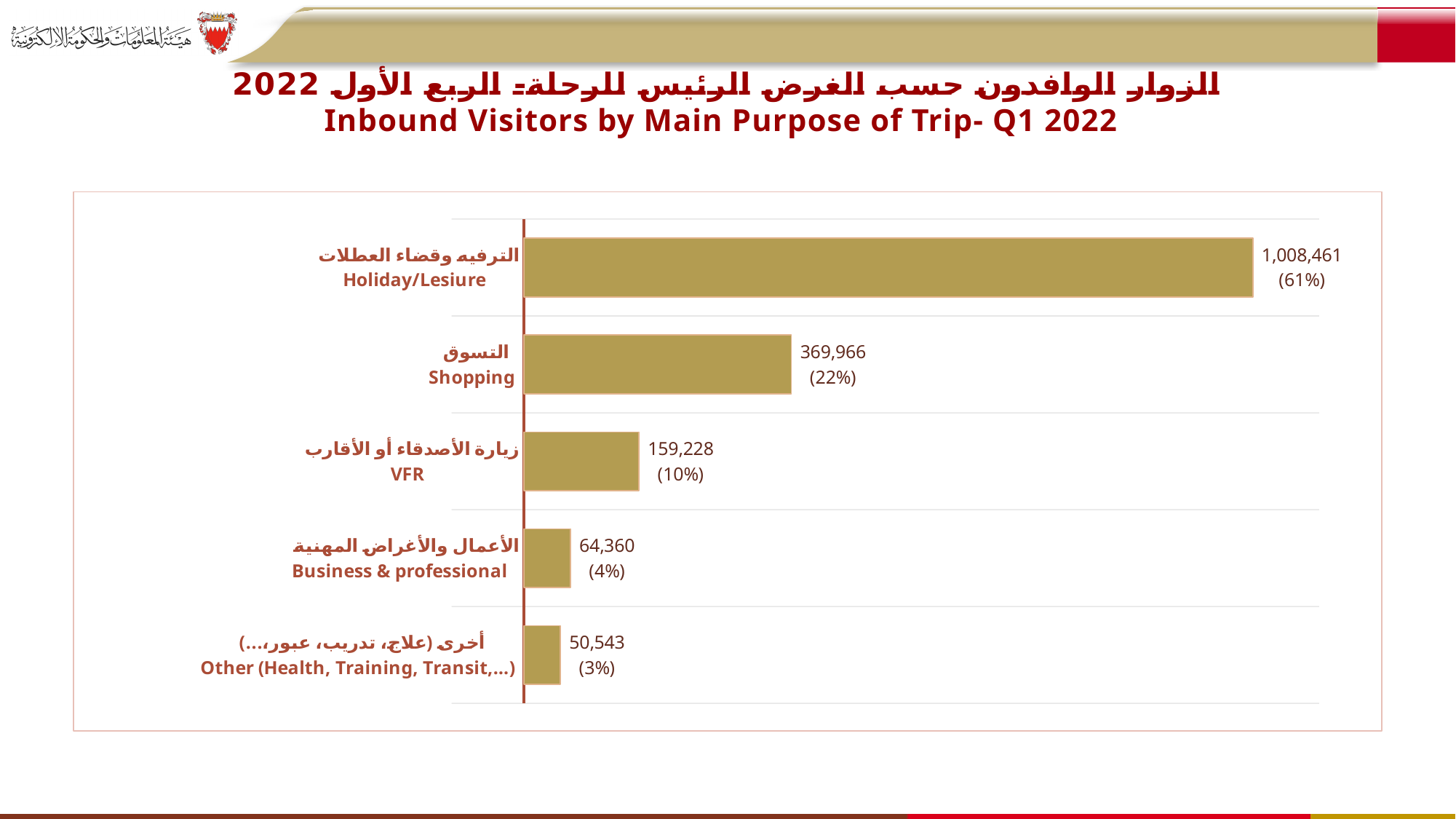
What is the number of inbound visitors for VFR? 159,228 What is the English title of the chart on this slide? Inbound Visitors by Main Purpose of Trip- Q1 2022 Which main purpose of trip has the lowest number of inbound visitors? Other (Health, Training, Transit,...) What is the difference in inbound visitors between Shopping and VFR? 210,738 What is the number of inbound visitors for Holiday/Lesiure? 1,008,461 What is the number of inbound visitors for Shopping? 369,966 What kind of chart is used on this slide? Bar chart What percentage share is shown for Other (Health, Training, Transit,...)? 3% What is the number of inbound visitors for Business & professional? 64,360 Which main purpose of trip has the highest number of inbound visitors? Holiday/Lesiure How many main purpose of trip categories are shown in the chart? 5 Which has more inbound visitors, Business & professional or Other (Health, Training, Transit,...)? Business & professional